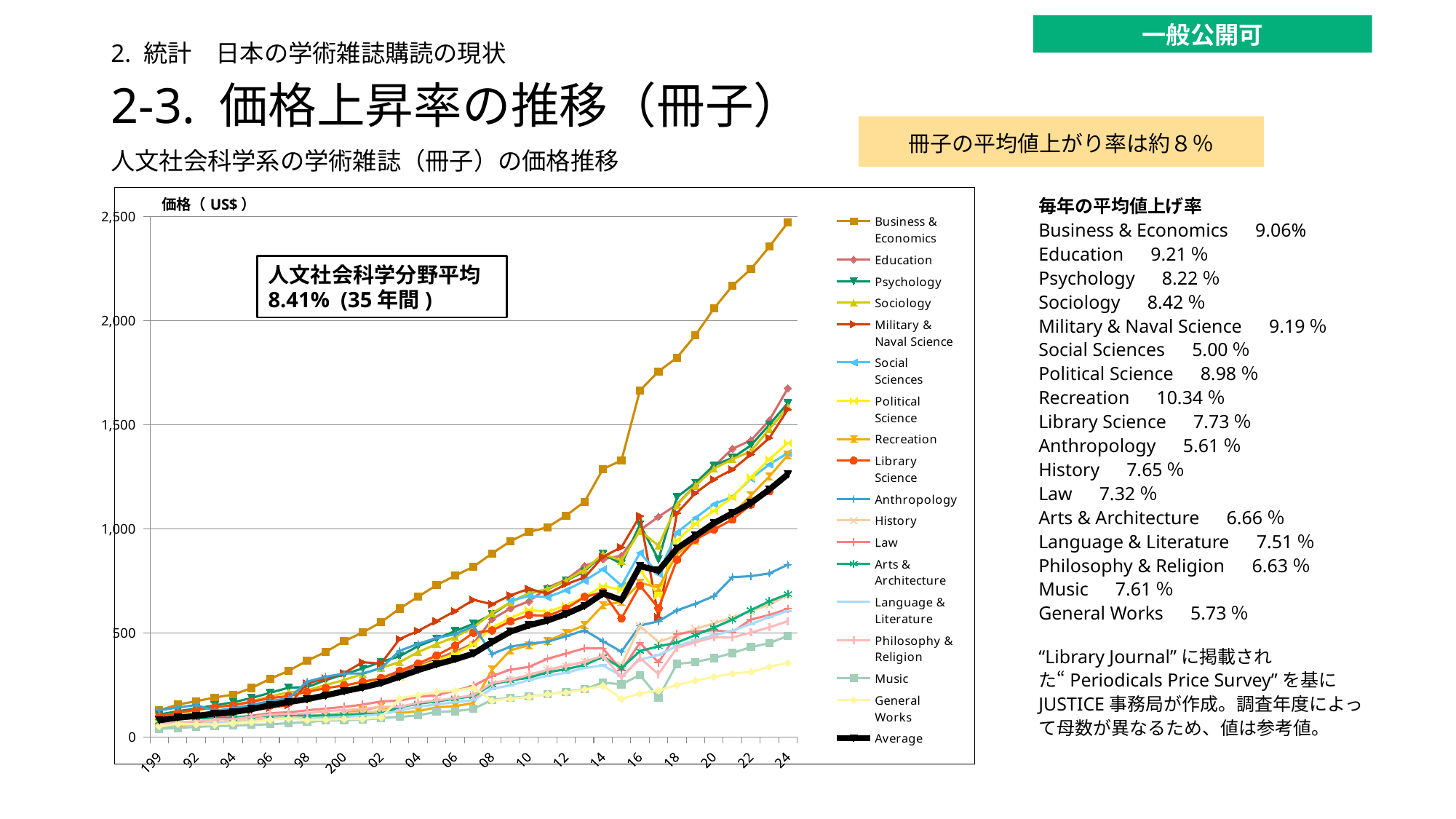
Is the value for Business & Economics in 2024 greater or less than 2,000? greater Which series has the highest value at the right end of the chart (2024)? Business & Economics Is the value for Average in 2024 greater or less than 1,000? greater Is the value for General Works in 2024 greater or less than 500? less What kind of chart is shown on the slide? line chart Which series has the lowest value at the right end of the chart (2024)? General Works In 2024, which is larger: the value for Music or the value for General Works? Music What is the label shown on the vertical axis of the chart? 価格（US$） How many series does the chart legend list? 18 Does the Business & Economics series rise or fall along the x axis overall? rise In 2024, which is larger: the value for Business & Economics or the value for Average? Business & Economics